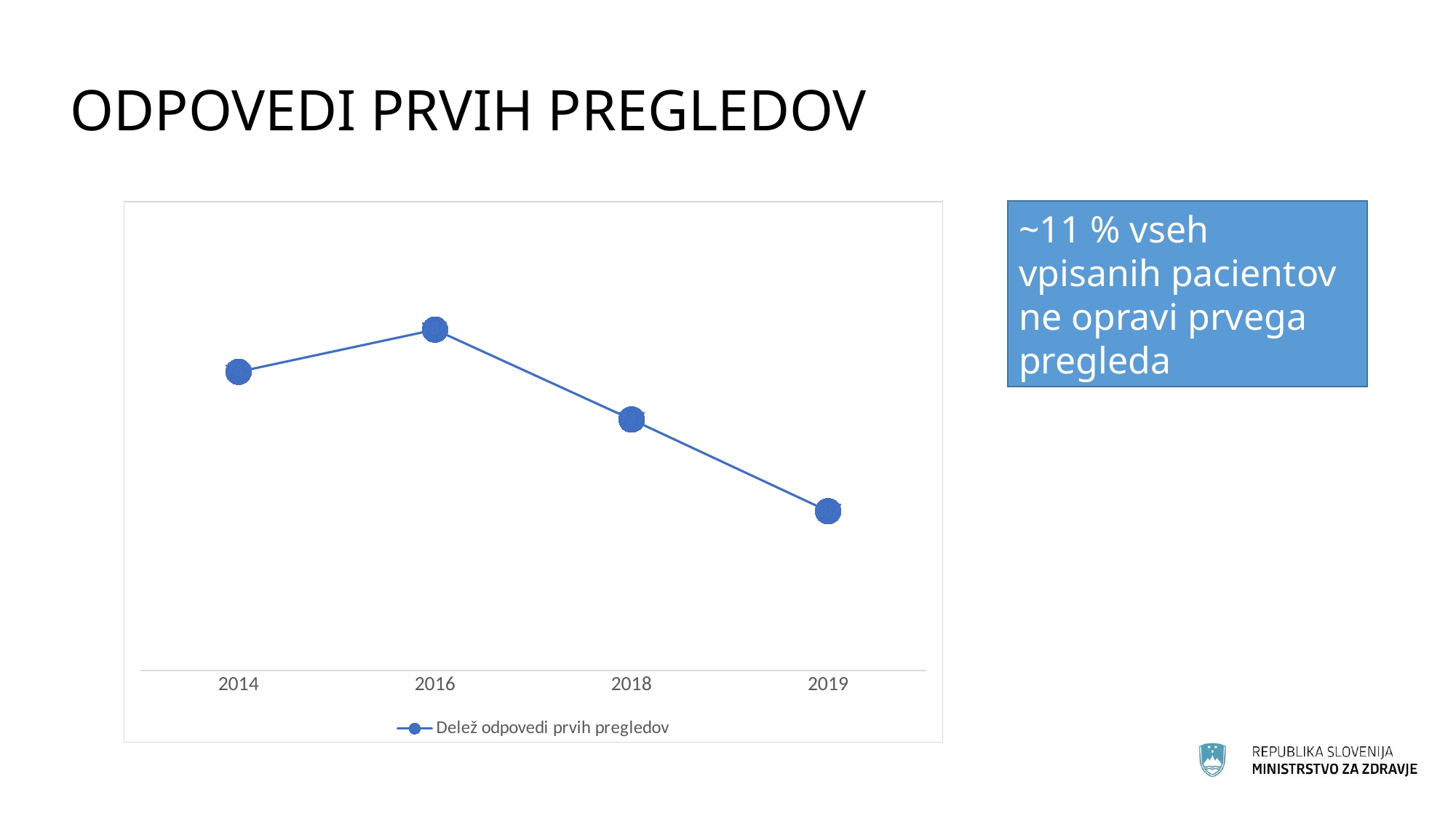
What is the name of the series shown in the chart legend? Delež odpovedi prvih pregledov Which year has the highest value on the chart? 2016 How many series does the legend of the chart list? 1 Does the value rise or fall from 2014 to 2016 on the chart? rise Which is higher on the chart, the value for 2016 or the value for 2014? 2016 Does the value rise or fall from 2016 to 2019 on the chart? fall Which year has the lowest value on the chart? 2019 What are the category labels on the x axis of the chart? 2014, 2016, 2018, 2019 Which is higher on the chart, the value for 2018 or the value for 2019? 2018 How many data points are plotted on the line chart? 4 What kind of chart is shown on the slide? line chart Which is higher on the chart, the value for 2014 or the value for 2018? 2014